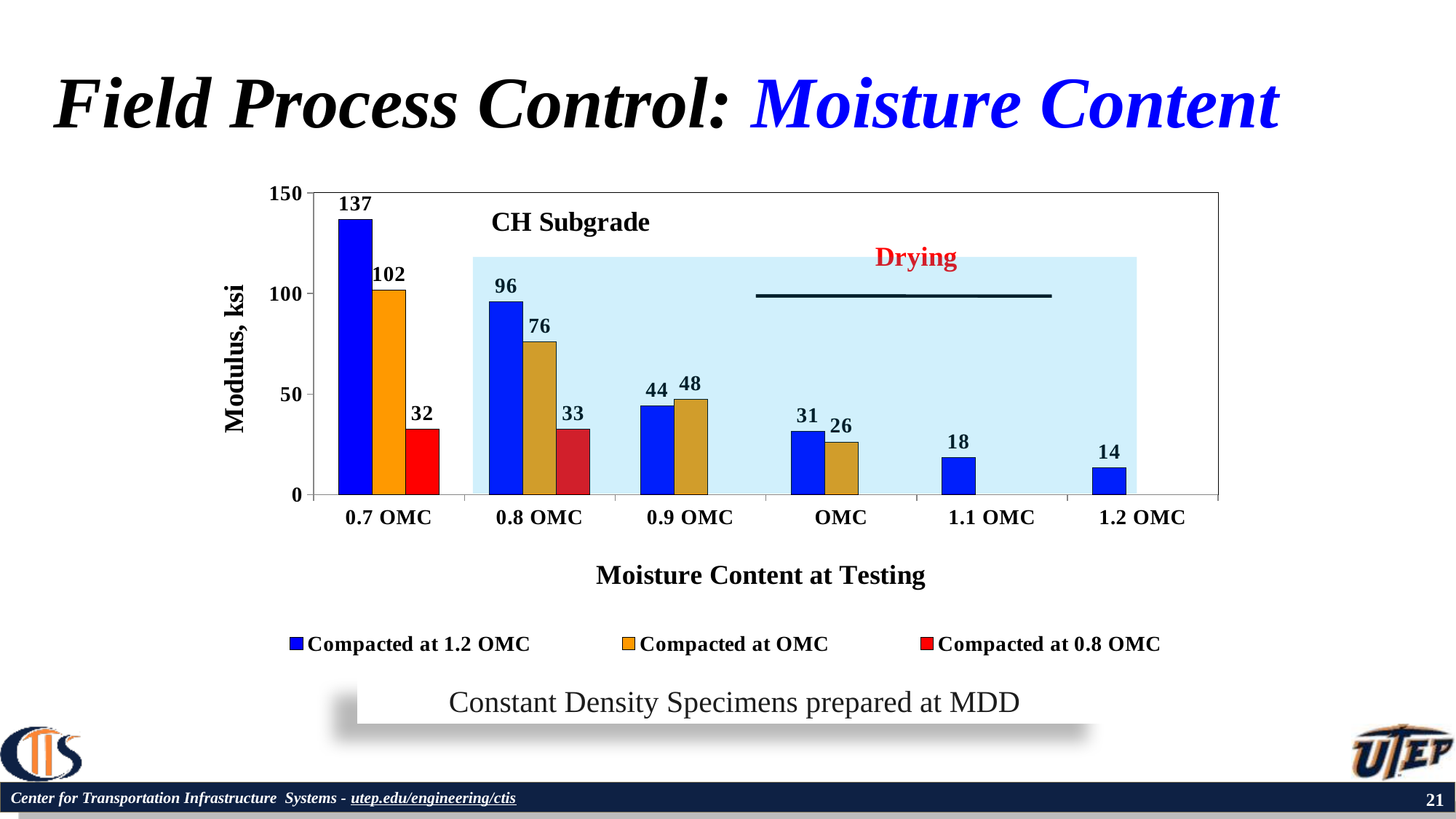
How many moisture content categories are shown on the x axis? 6 What is the difference between the Compacted at 1.2 OMC and Compacted at OMC modulus values at 0.7 OMC? 35 What kind of chart is shown on the slide? Bar chart What is the modulus for Compacted at OMC at 0.8 OMC moisture content at testing? 76 How many series does the legend list? 3 What is the modulus for Compacted at 1.2 OMC at 1.2 OMC moisture content at testing? 14 At 0.9 OMC, which series has the larger modulus: Compacted at 1.2 OMC or Compacted at OMC? Compacted at OMC At which moisture content at testing is the Compacted at 1.2 OMC modulus highest? 0.7 OMC Does the Compacted at 1.2 OMC modulus rise or fall as moisture content at testing increases from 0.7 OMC to 1.2 OMC? Fall What is the modulus for Compacted at 1.2 OMC at 0.7 OMC moisture content at testing? 137 At which moisture content at testing is the Compacted at 1.2 OMC modulus lowest? 1.2 OMC What is the modulus for Compacted at 0.8 OMC at 0.7 OMC moisture content at testing? 32